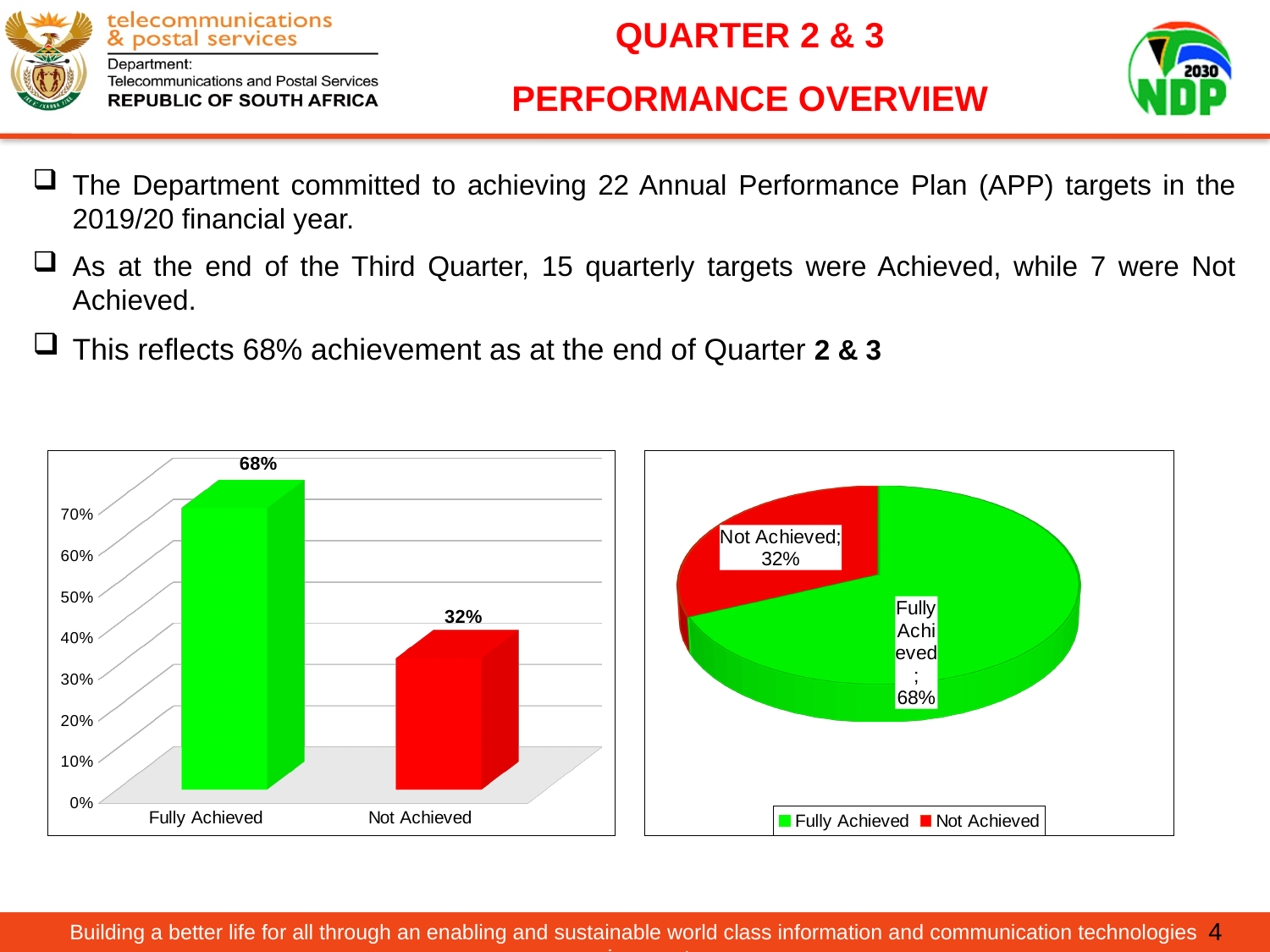
In the pie chart on the right, what share does the Not Achieved slice represent? 32% In the bar chart on the left, what is the value for Not Achieved? 32% How many categories are shown in the bar chart on the left? 2 In the bar chart on the left, which category has the lowest value? Not Achieved In the bar chart on the left, is the value for Not Achieved greater or less than 40%? less What kind of chart is the chart on the right? pie chart In the bar chart on the left, which category has the highest value? Fully Achieved In the bar chart on the left, what is the difference between the Fully Achieved and Not Achieved values? 36% What kind of chart is the chart on the left? bar chart In the pie chart on the right, which slice is larger, Fully Achieved or Not Achieved? Fully Achieved How many entries does the legend of the pie chart on the right list? 2 In the bar chart on the left, what is the value for Fully Achieved? 68%